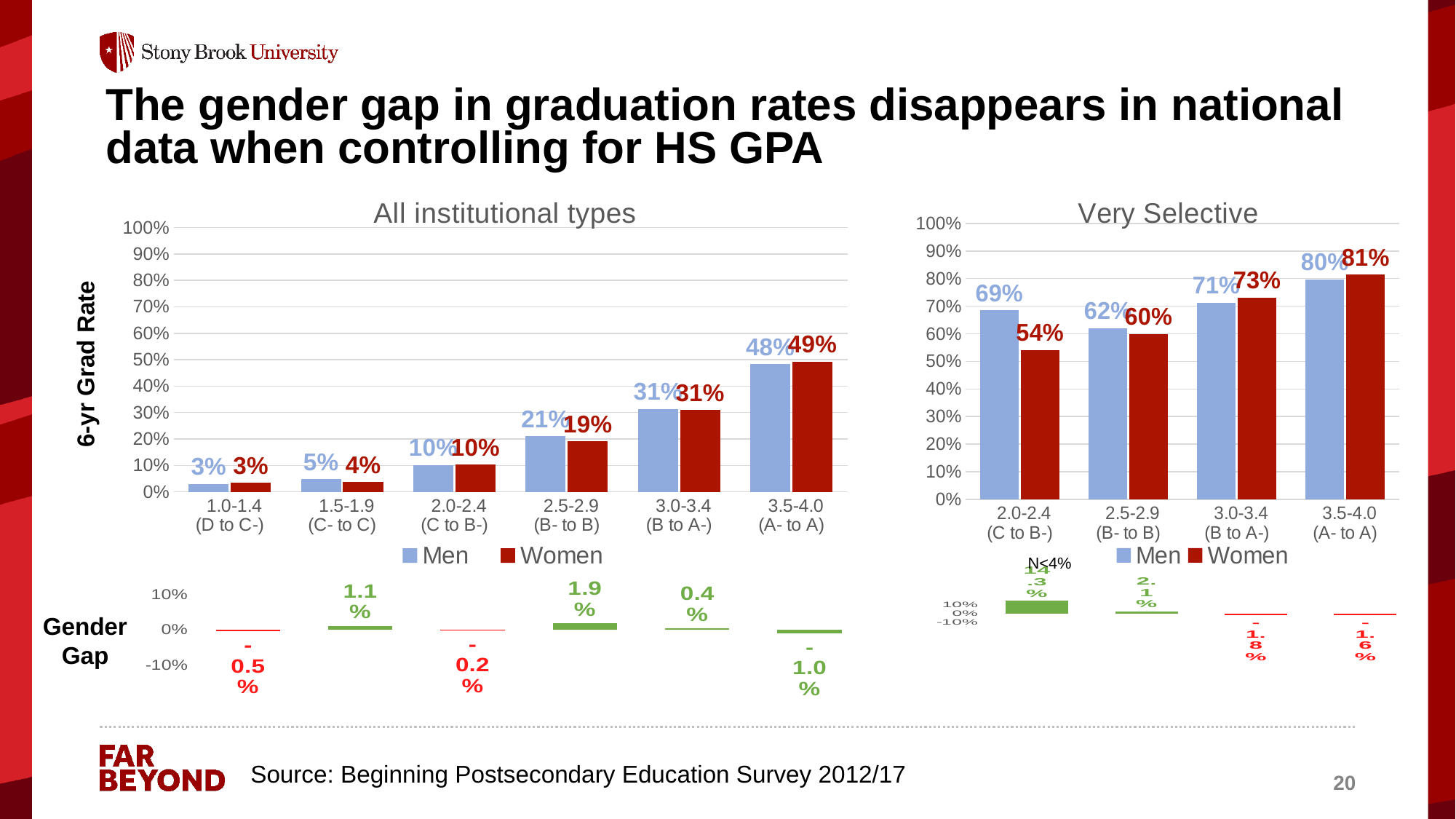
In the 'Very Selective' chart, what is the 6-yr grad rate for Men in the 2.0-2.4 (C to B-) GPA group? 69% In the 'Very Selective' chart, is the Women grad rate for the 3.0-3.4 (B to A-) group greater or less than 70%? greater In the 'Very Selective' chart, which GPA group has the lowest grad rate for Women? 2.0-2.4 (C to B-) In the 'All institutional types' chart, which is larger in the 2.5-2.9 (B- to B) group: the Men or the Women grad rate? Men How many series does the legend of the 'Very Selective' chart list? 2 What kind of chart is the 'Very Selective' chart? Bar chart In the 'All institutional types' chart, do the Men grad rates rise or fall as HS GPA increases along the x axis? Rise In the 'Very Selective' chart, what is the difference between the Men and Women grad rates in the 2.0-2.4 (C to B-) group? 15% How many GPA groups are shown on the x axis of the 'All institutional types' chart? 6 What is the y-axis label of the 'All institutional types' chart? 6-yr Grad Rate In the 'All institutional types' chart, what is the 6-yr grad rate for Women in the 3.5-4.0 (A- to A) GPA group? 49% In the 'All institutional types' chart, which GPA group has the highest grad rate for Men? 3.5-4.0 (A- to A)